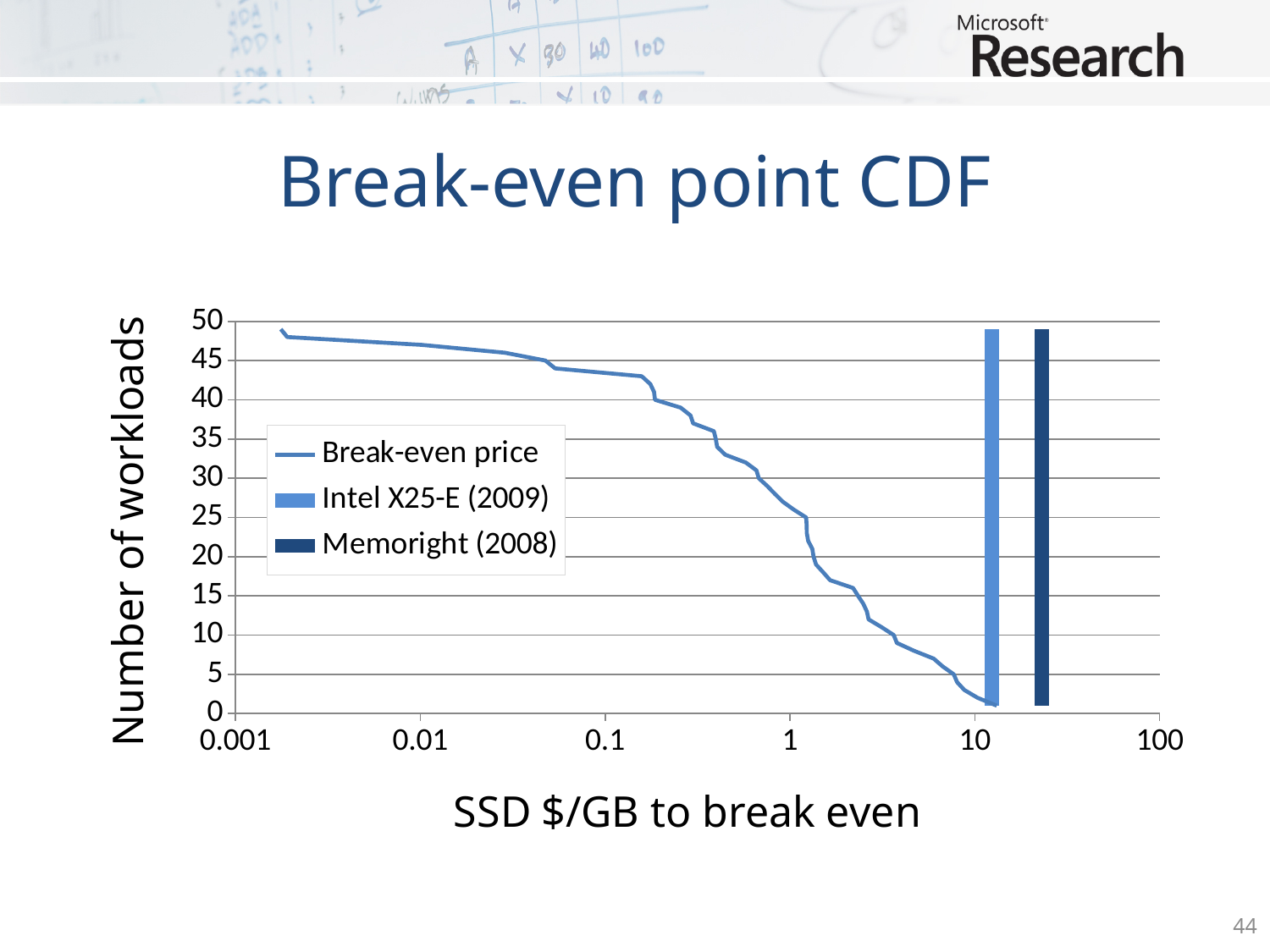
How many series does the legend list? 3 What is the title of the chart? Break-even point CDF What is the highest value shown on the y axis? 50 Is the number of workloads on the break-even price line at 10 $/GB greater or less than 5? less Which SSD price marker is further to the right on the x axis, Intel X25-E (2009) or Memoright (2008)? Memoright (2008) What kind of chart is used to show the break-even price? line chart Is the Memoright (2008) price marker greater or less than 100 $/GB? less Is the number of workloads on the break-even price line at 0.01 $/GB greater or less than 45? greater What is the label of the x axis? SSD $/GB to break even Does the break-even price line rise or fall as the SSD $/GB increases along the x axis? fall